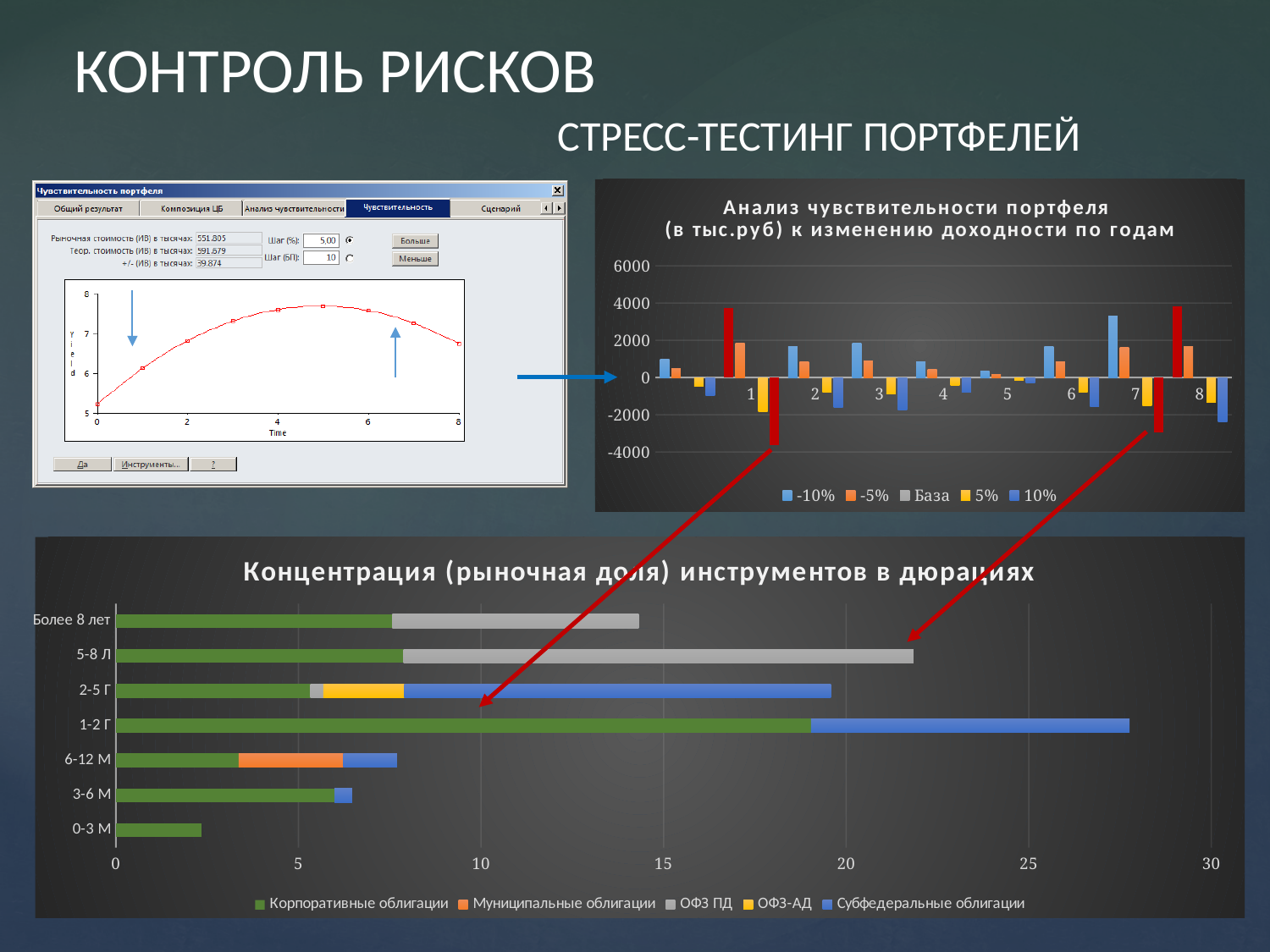
On the bottom chart "Концентрация (рыночная доля) инструментов в дюрациях", which duration category has the shortest total bar? 0-3 М On the bottom chart "Концентрация (рыночная доля) инструментов в дюрациях", is the total bar for 1-2 Г greater or less than 25? greater How many year categories are shown on the x axis of the top-right chart "Анализ чувствительности портфеля"? 8 On the bottom chart "Концентрация (рыночная доля) инструментов в дюрациях", which series is shown in green in the legend? Корпоративные облигации What type of chart is the bottom chart titled "Концентрация (рыночная доля) инструментов в дюрациях"? Bar chart On the bottom chart "Концентрация (рыночная доля) инструментов в дюрациях", is the total bar for 6-12 М greater or less than 10? less How many duration categories are shown on the bottom chart "Концентрация (рыночная доля) инструментов в дюрациях"? 7 On the bottom chart "Концентрация (рыночная доля) инструментов в дюрациях", which duration category has the longest total bar? 1-2 Г On the top-right chart "Анализ чувствительности портфеля", is the -10% bar for year 7 greater or less than 2000? greater How many series does the legend of the top-right chart "Анализ чувствительности портфеля" list? 5 How many series does the legend of the bottom chart "Концентрация (рыночная доля) инструментов в дюрациях" list? 5 On the bottom chart "Концентрация (рыночная доля) инструментов в дюрациях", which total bar is longer: 5-8 Л or 2-5 Г? 5-8 Л